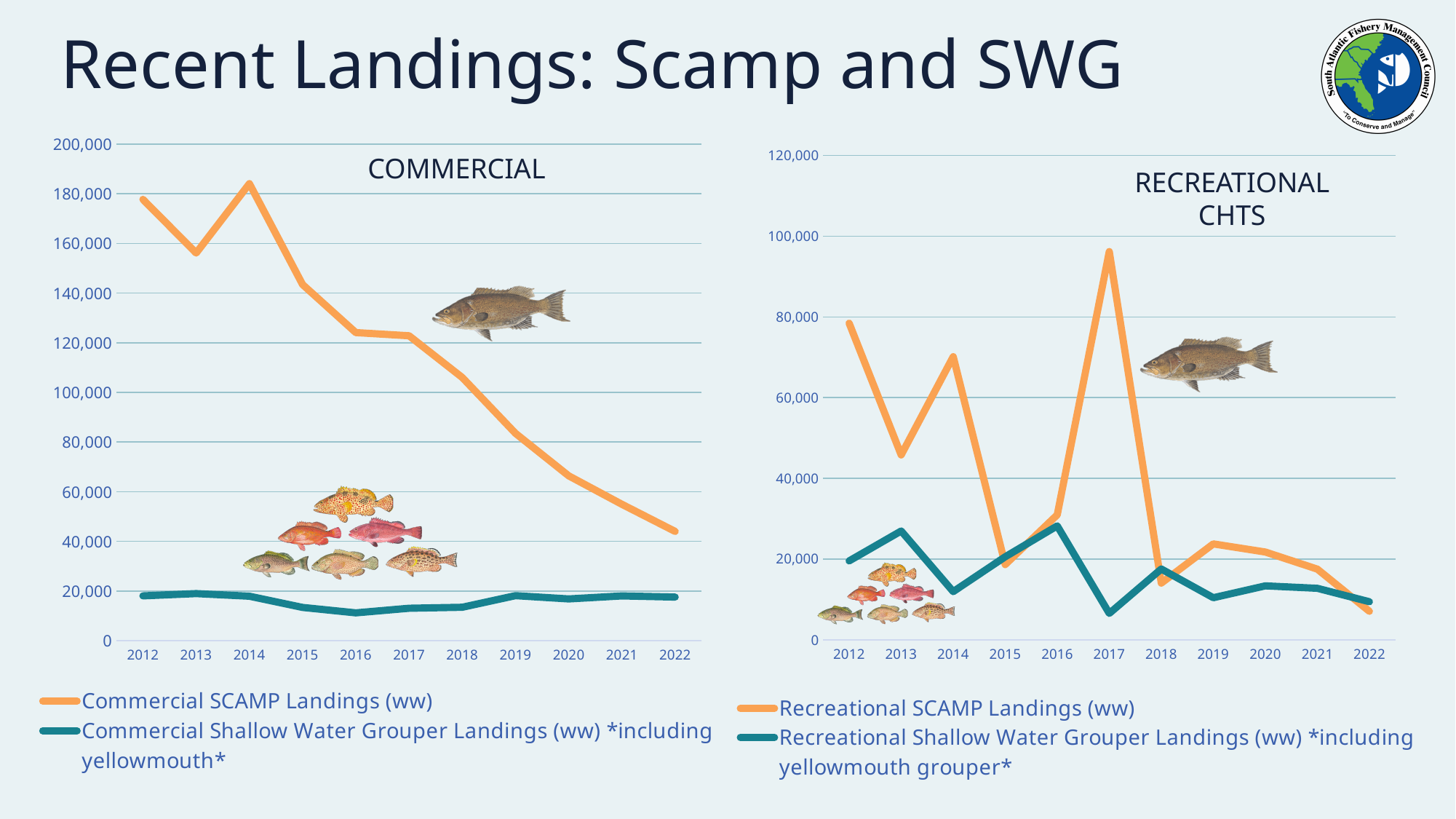
What type of chart is the COMMERCIAL chart? line chart In the RECREATIONAL CHTS chart, is the value for Recreational SCAMP Landings in 2017 greater or less than 80,000? greater In the COMMERCIAL chart, which year has the highest Commercial SCAMP Landings? 2014 In the COMMERCIAL chart, do Commercial SCAMP Landings generally rise or fall from 2014 to 2022? fall In the COMMERCIAL chart, is the value for Commercial SCAMP Landings in 2022 greater or less than 60,000? less In the RECREATIONAL CHTS chart, which year has the highest Recreational SCAMP Landings? 2017 How many series does the legend of the RECREATIONAL CHTS chart list? 2 In the RECREATIONAL CHTS chart, which year has the highest Recreational Shallow Water Grouper Landings? 2016 How many years are shown on the x axis of the COMMERCIAL chart? 11 In the COMMERCIAL chart, is the value for Commercial SCAMP Landings in 2012 greater or less than 160,000? greater In the COMMERCIAL chart, which year has the lowest Commercial SCAMP Landings? 2022